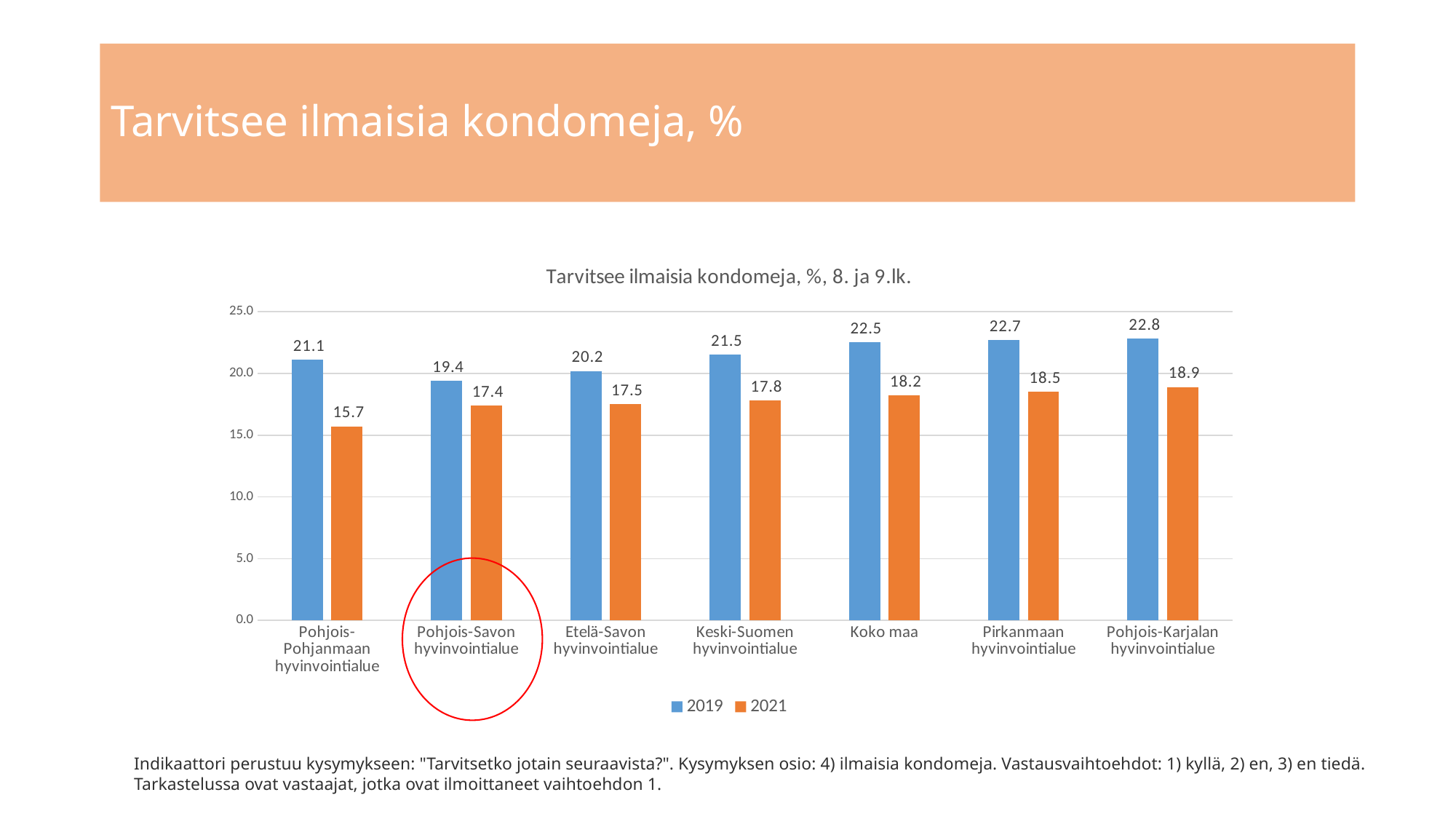
Which category has the lowest 2021 value? Pohjois-Pohjanmaan hyvinvointialue Which category has the highest 2019 value? Pohjois-Karjalan hyvinvointialue What is the 2021 value for Pohjois-Pohjanmaan hyvinvointialue? 15.7 Is the 2021 value for Pirkanmaan hyvinvointialue greater or less than 20.0? less What is the difference between the 2019 and 2021 values for Pohjois-Pohjanmaan hyvinvointialue? 5.4 How many series does the legend list? 2 How many categories are shown on the x axis? 7 What is the 2021 value for Koko maa? 18.2 Which category is circled in red on the chart? Pohjois-Savon hyvinvointialue What kind of chart is shown on the slide? bar chart Which is larger for Keski-Suomen hyvinvointialue, the 2019 value or the 2021 value? 2019 What is the 2019 value for Pohjois-Savon hyvinvointialue? 19.4